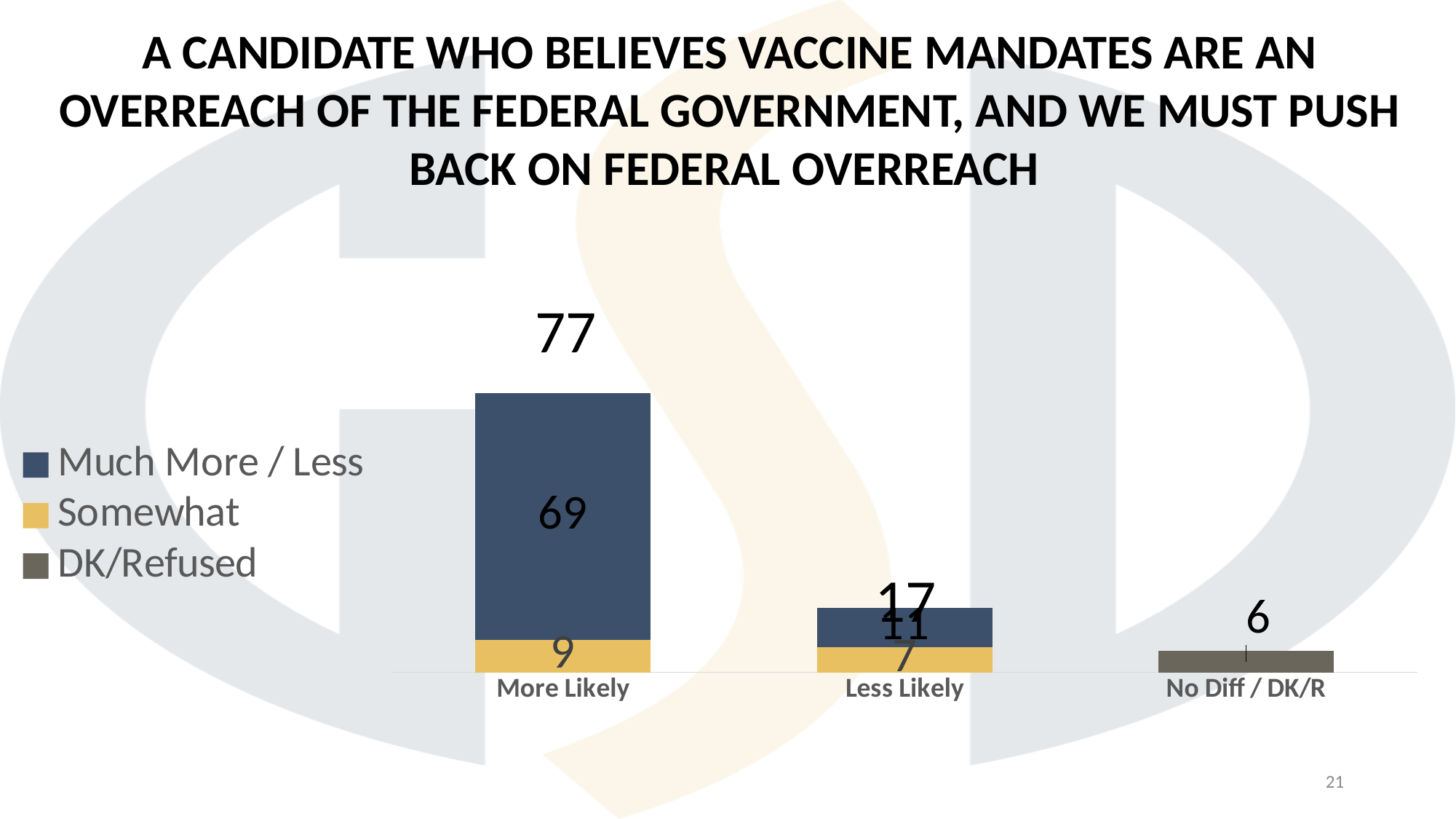
What kind of chart is shown on the slide? Stacked bar chart How many series does the legend list? 3 Which category has the lowest total? No Diff / DK/R What total is printed above the More Likely bar? 77 What total is printed above the Less Likely bar? 17 Which category has the highest total? More Likely What is the Much More / Less value for the Less Likely category? 11 What is the value shown for the No Diff / DK/R category? 6 What is the Somewhat value for the More Likely category? 9 What is the difference between the Much More / Less values for More Likely and Less Likely? 58 What is the Much More / Less value for the More Likely category? 69 What is the Somewhat value for the Less Likely category? 7